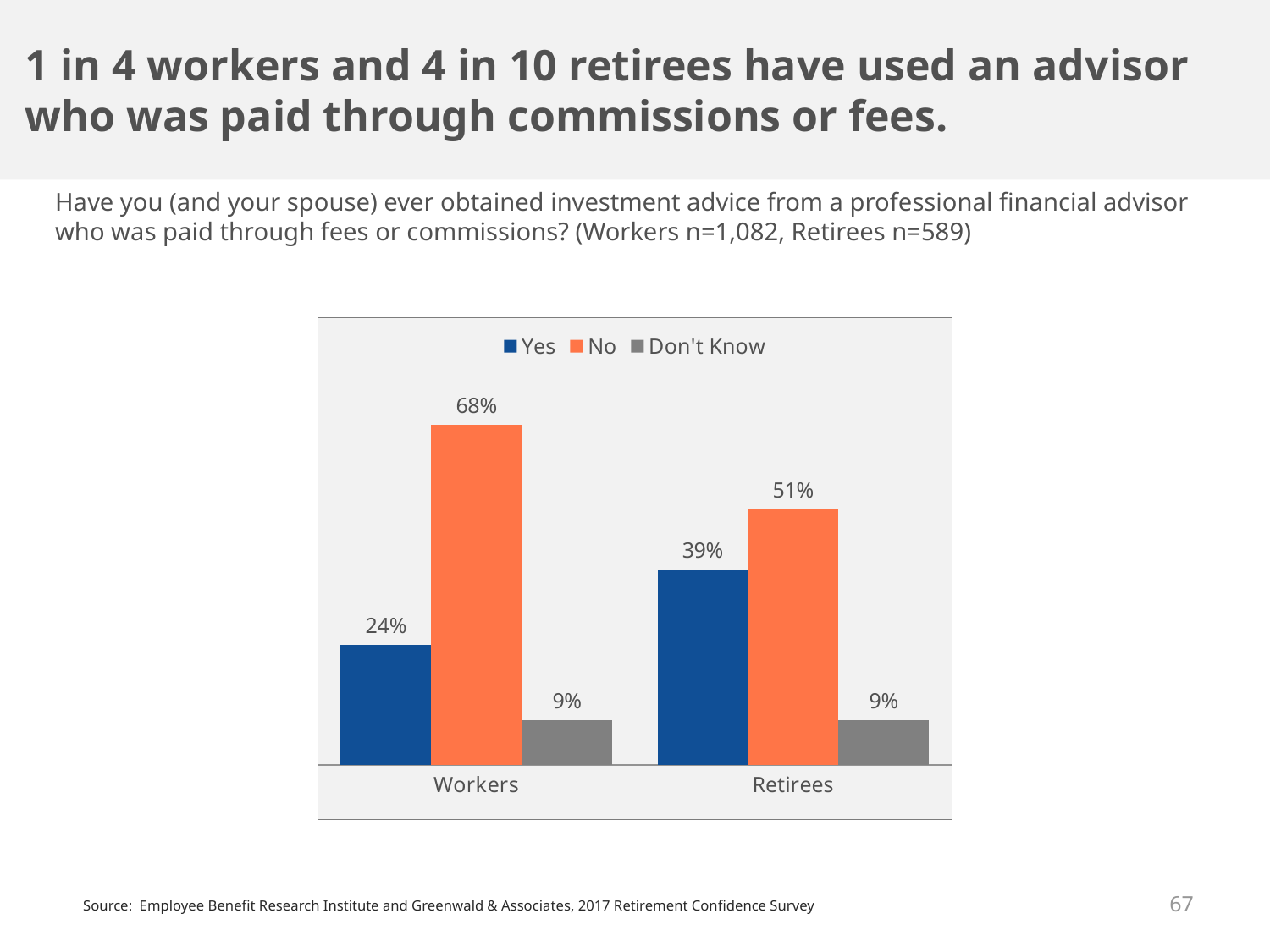
What percentage of Retirees answered No? 51% Which response has the highest value among Workers? No What percentage of Retirees answered Don't Know? 9% What is the difference between the No percentages for Workers and Retirees? 17% Which response has the lowest value among Retirees? Don't Know What colour are the bars for the No series? Orange How many categories are shown on the x axis? 2 Which is larger: the Yes value for Workers or the Yes value for Retirees? Retirees How many series does the legend list? 3 What kind of chart is shown on the slide? Bar chart What is the difference between the Yes percentages for Retirees and Workers? 15% What percentage of Workers answered Yes? 24%